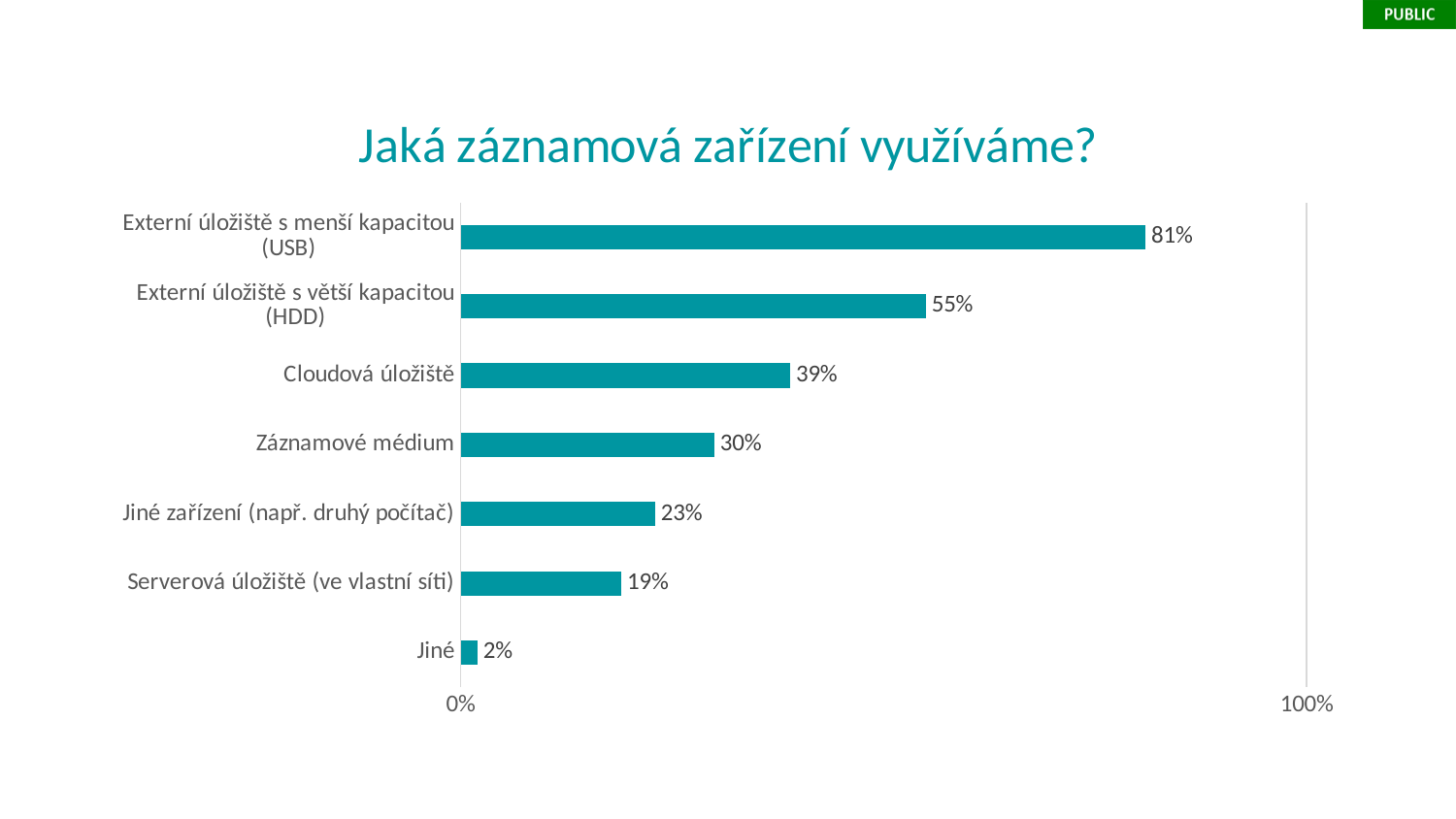
What is the value for Cloudová úložiště? 39% Which is larger, the value for Cloudová úložiště or the value for Záznamové médium? Cloudová úložiště Which category has the lowest value? Jiné Which category has the highest value? Externí úložiště s menší kapacitou (USB) What is the value for Externí úložiště s menší kapacitou (USB)? 81% What is the maximum value shown on the horizontal axis? 100% What kind of chart is shown on the slide? Bar chart What is the title of the chart? Jaká záznamová zařízení využíváme? What is the difference between the values for Záznamové médium and Jiné zařízení (např. druhý počítač)? 7% What is the difference between the values for Externí úložiště s menší kapacitou (USB) and Externí úložiště s větší kapacitou (HDD)? 26% What is the value for Serverová úložiště (ve vlastní síti)? 19% How many categories are shown in the chart? 7